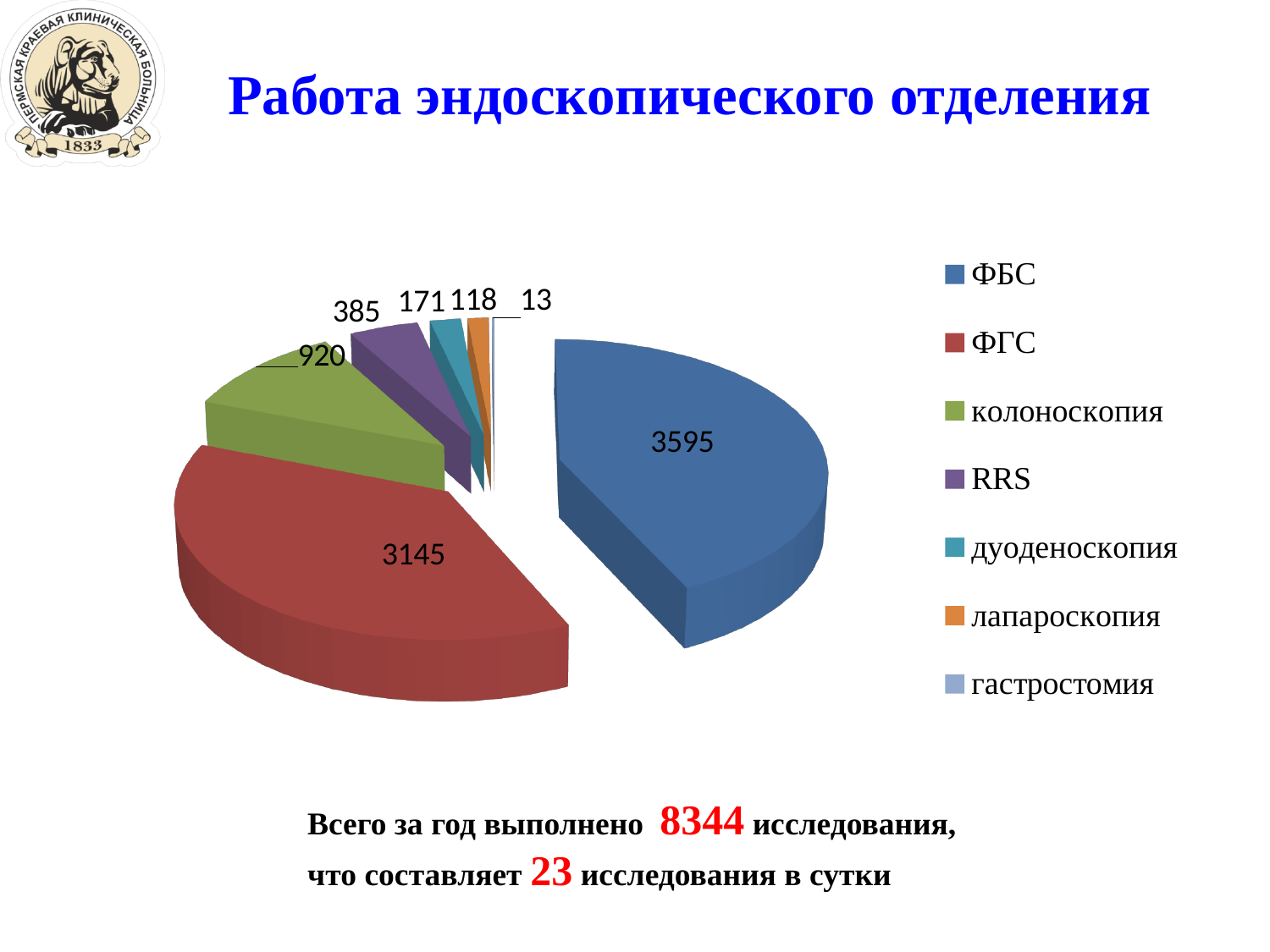
Which category has the smallest slice? гастростомия How many categories does the pie chart have? 7 What is the value for ФГС? 3145 What type of chart is shown on the slide? pie chart What is the title of the slide containing the chart? Работа эндоскопического отделения What is the value for колоноскопия? 920 What is the difference between the values for ФБС and ФГС? 450 What is the value for дуоденоскопия? 171 What is the value for ФБС? 3595 What is the value for RRS? 385 Which category has the largest slice? ФБС Which is larger, the value for колоноскопия or the value for RRS? колоноскопия